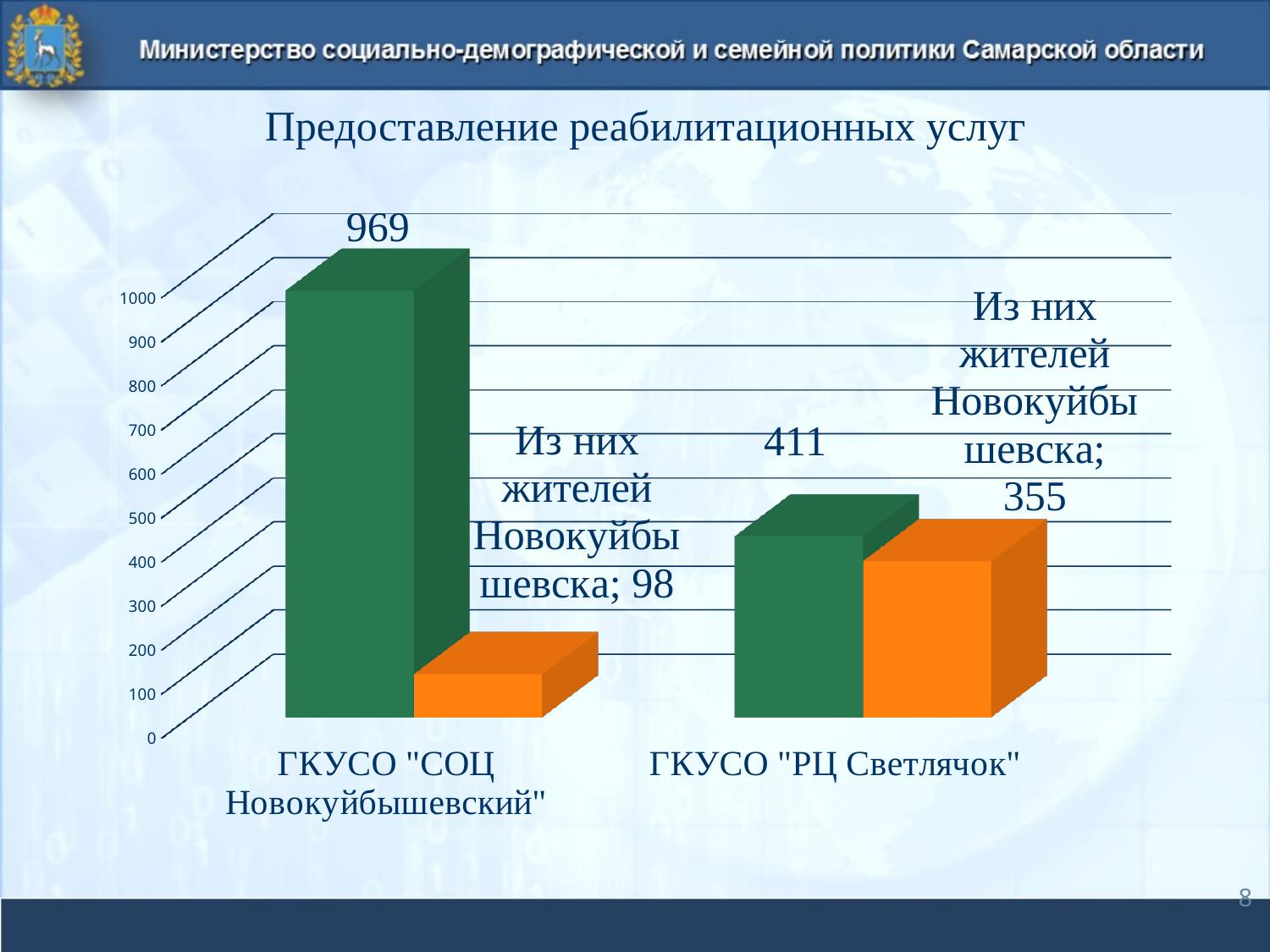
How many categories are shown on the x axis of the chart? 2 What is the title of the chart on the slide? Предоставление реабилитационных услуг Which is larger: the orange bar for ГКУСО "РЦ Светлячок" or the orange bar for ГКУСО "СОЦ Новокуйбышевский"? ГКУСО "РЦ Светлячок" What is the difference between the green bar values of ГКУСО "СОЦ Новокуйбышевский" and ГКУСО "РЦ Светлячок"? 558 How many residents of Novokuybyshevsk ("Из них жителей Новокуйбышевска") are shown for ГКУСО "СОЦ Новокуйбышевский"? 98 How many residents of Novokuybyshevsk ("Из них жителей Новокуйбышевска") are shown for ГКУСО "РЦ Светлячок"? 355 What kind of chart is shown on the slide? Bar chart What is the value of the green bar for ГКУСО "СОЦ Новокуйбышевский"? 969 What is the difference between the green and orange bar values for ГКУСО "РЦ Светлячок"? 56 Which category has the highest green bar? ГКУСО "СОЦ Новокуйбышевский" Which category has the lowest orange bar? ГКУСО "СОЦ Новокуйбышевский" What is the value of the green bar for ГКУСО "РЦ Светлячок"? 411